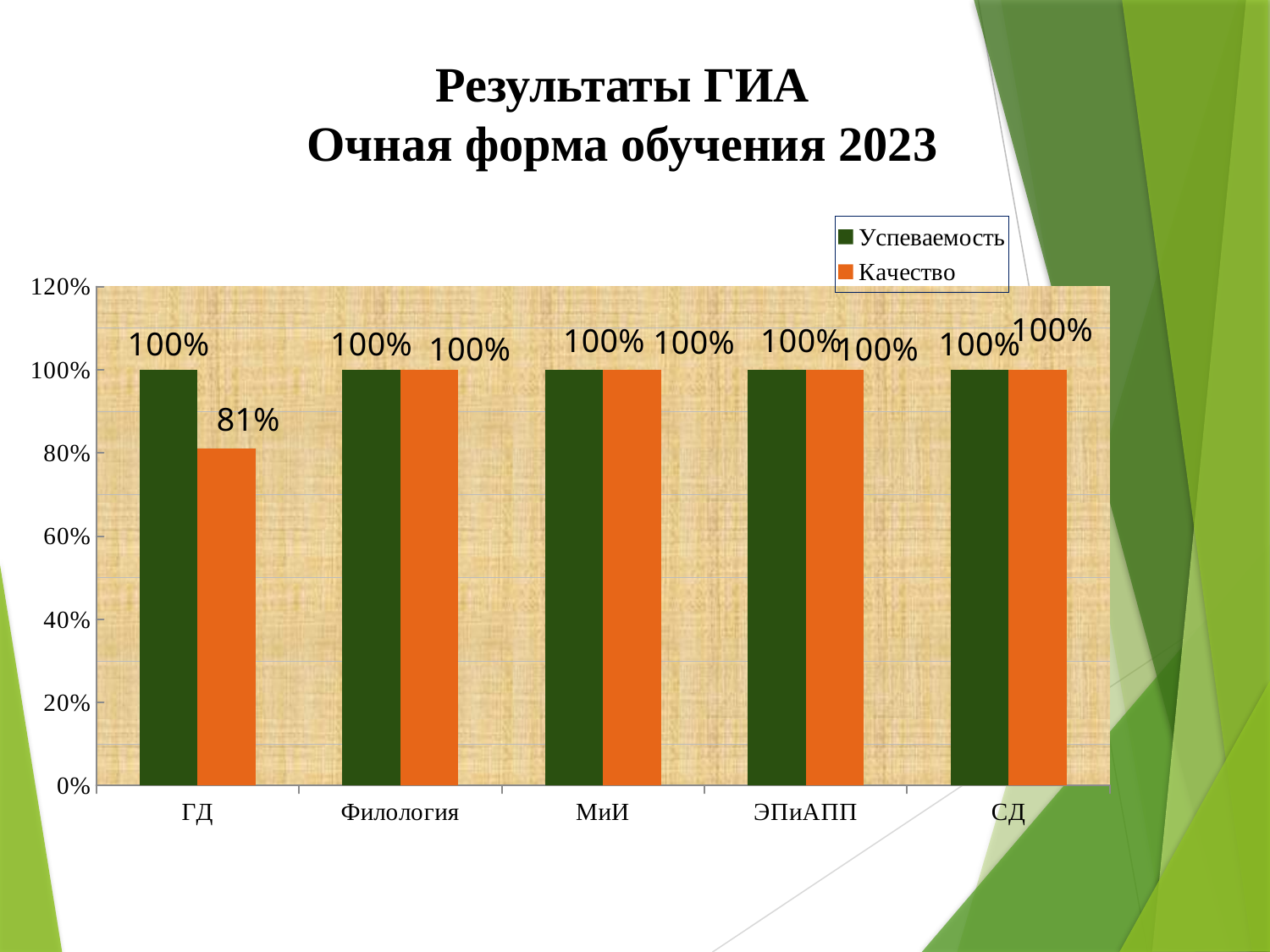
Is the Качество value for ГД greater or less than 60%? greater What is the Качество value for СД? 100% What is the Успеваемость value for Филология? 100% How many series does the legend list? 2 What is the difference between the Успеваемость and Качество values for ГД? 19% What is the title of the slide? Результаты ГИА Очная форма обучения 2023 What kind of chart is shown on the slide? Bar chart For ГД, which is larger: Успеваемость or Качество? Успеваемость What is the Качество value for ГД? 81% Which category has the lowest Качество value? ГД How many categories are shown on the x axis? 5 Which colour represents the Качество series? Orange